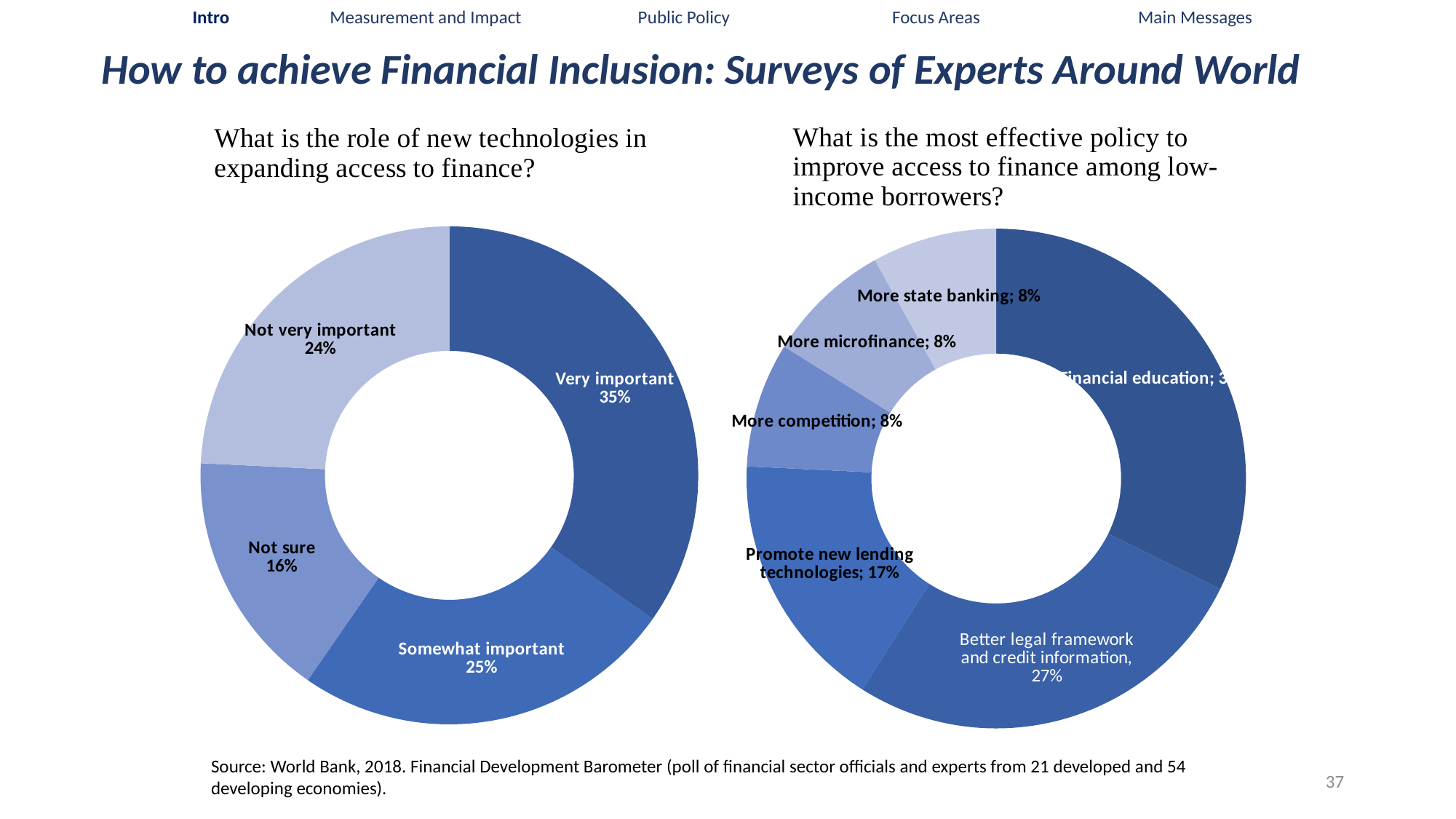
What type of chart is used on this slide? Pie (donut) chart In the left chart on the role of new technologies, which response has the smallest share? Not sure In the right chart on the most effective policy, how many policy categories are shown? 6 In the left chart on the role of new technologies, what share of experts said 'Not sure'? 16% In the left chart on the role of new technologies, how many response categories are shown? 4 In the left chart on the role of new technologies, what share of experts said 'Very important'? 35% In the right chart on the most effective policy, which is larger: 'Better legal framework and credit information' or 'Promote new lending technologies'? Better legal framework and credit information In the right chart on the most effective policy, what share of experts chose 'Promote new lending technologies'? 17% In the right chart on the most effective policy, what share of experts chose 'More competition'? 8% In the left chart on the role of new technologies, which response has the largest share? Very important In the right chart on the most effective policy, what share of experts chose 'Better legal framework and credit information'? 27% In the left chart on the role of new technologies, what is the difference between the 'Very important' and 'Somewhat important' shares? 10%